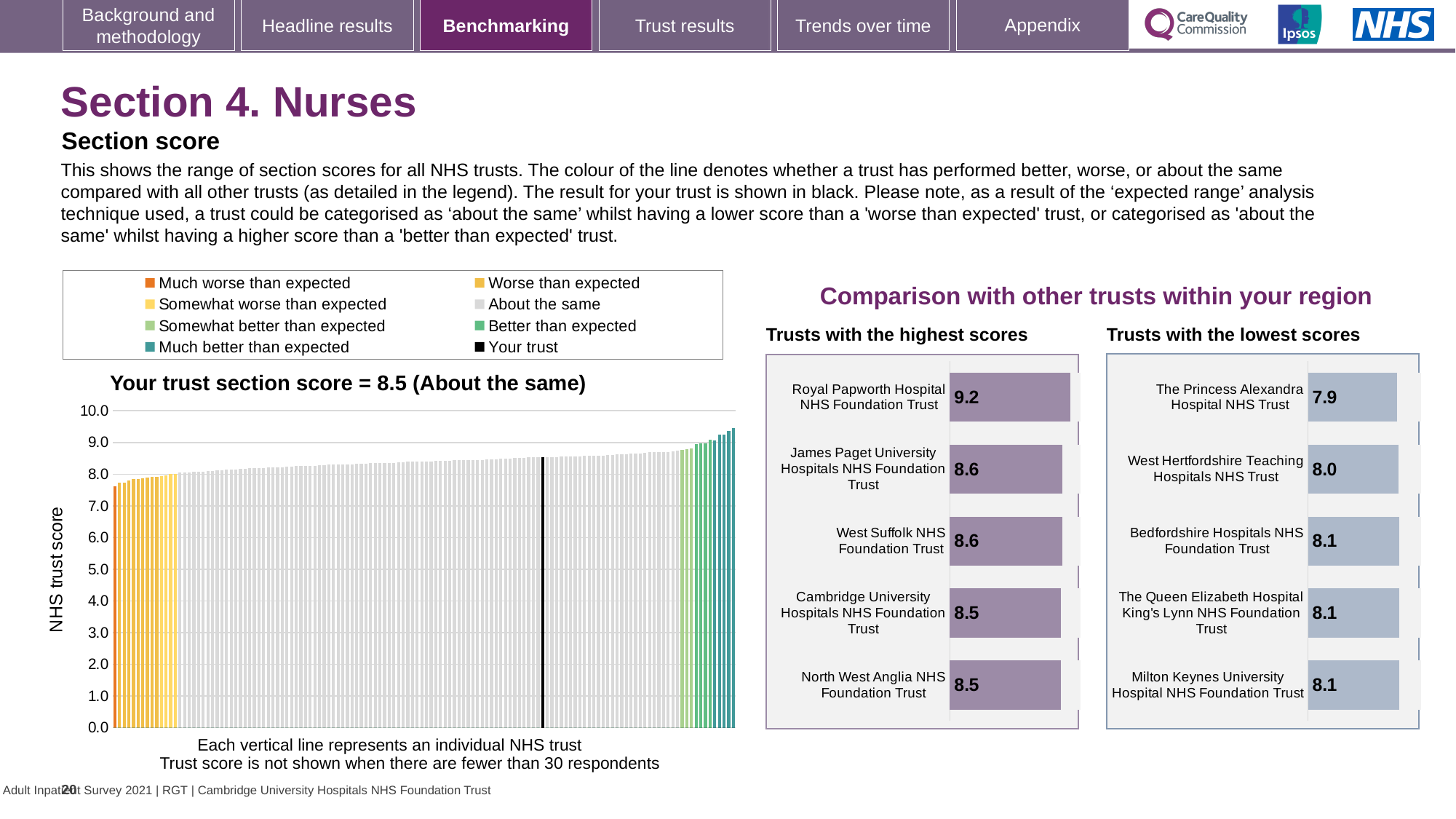
In the 'Trusts with the highest scores' chart, what is the difference between the scores of Royal Papworth Hospital NHS Foundation Trust and North West Anglia NHS Foundation Trust? 0.7 In the 'Trusts with the highest scores' chart, how many trusts are shown? 5 Which has the larger score: Royal Papworth Hospital NHS Foundation Trust in the highest scores chart or The Princess Alexandra Hospital NHS Trust in the lowest scores chart? Royal Papworth Hospital NHS Foundation Trust In the 'Trusts with the lowest scores' chart, what is the difference between the scores of Milton Keynes University Hospital NHS Foundation Trust and The Princess Alexandra Hospital NHS Trust? 0.2 In the 'Trusts with the lowest scores' chart, what is the score for The Princess Alexandra Hospital NHS Trust? 7.9 In the 'Trusts with the lowest scores' chart, which trust has the lowest score? The Princess Alexandra Hospital NHS Trust In the 'Trusts with the highest scores' chart, what is the score for Royal Papworth Hospital NHS Foundation Trust? 9.2 In the main chart on the left showing all NHS trusts, what is your trust's section score? 8.5 In the 'Trusts with the highest scores' chart, which trust has the highest score? Royal Papworth Hospital NHS Foundation Trust How many entries does the legend above the main chart on the left list? 8 In the 'Trusts with the lowest scores' chart, what is the score for West Hertfordshire Teaching Hospitals NHS Trust? 8.0 In the main chart on the left showing all NHS trusts, do the values rise or fall from left to right? rise